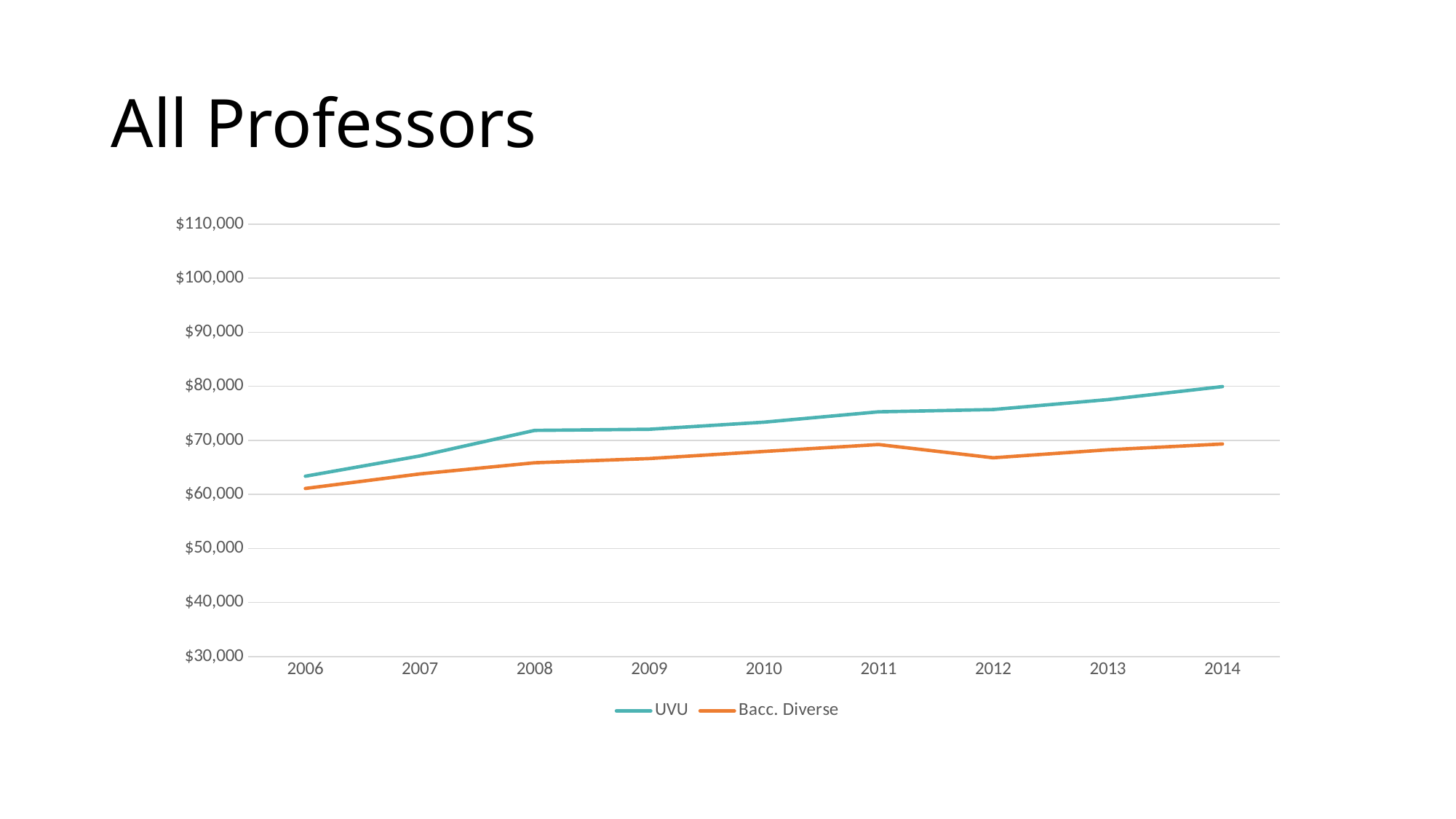
What kind of chart is shown on the slide? line chart Which series is drawn in orange? Bacc. Diverse How many series does the legend list? 2 Does the UVU series generally rise or fall from 2006 to 2014? rise Is the value for UVU in 2014 greater or less than $70,000? greater Which series has the higher value in 2014, UVU or Bacc. Diverse? UVU How many years are shown on the x axis? 9 Is the value for Bacc. Diverse in 2006 greater or less than $70,000? less In which year does the UVU series reach its highest value? 2014 Is the value for Bacc. Diverse in 2012 greater or less than $70,000? less What is the title of the slide containing the chart? All Professors